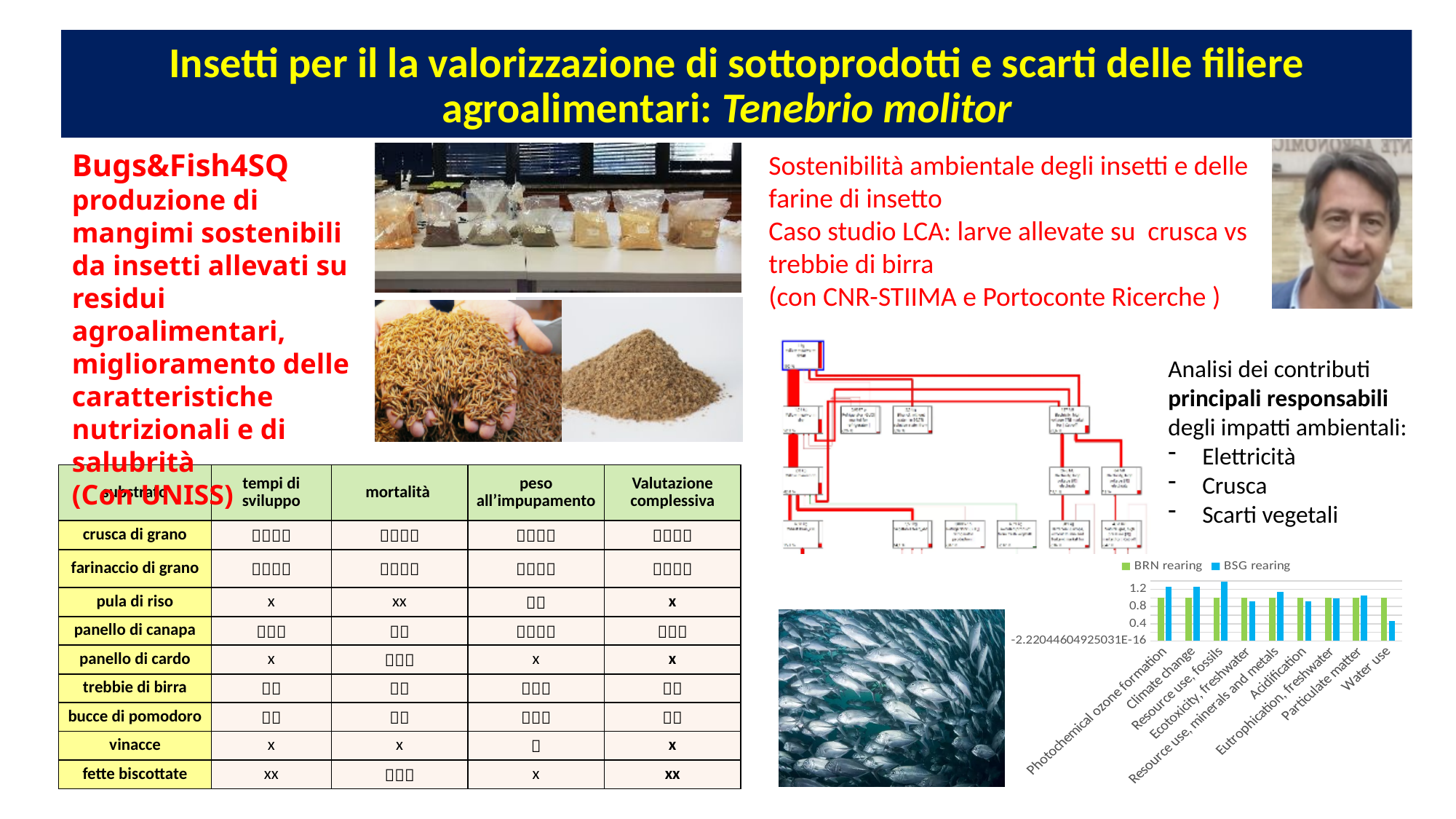
In the bar chart, is the BSG rearing value for Acidification greater or less than 0.4? greater In the bar chart, for Climate change, which series has the larger value: BRN rearing or BSG rearing? BSG rearing How many series does the legend of the bar chart list? 2 In the bar chart, for Water use, which series has the larger value: BRN rearing or BSG rearing? BRN rearing In the bar chart, is the BSG rearing value for Photochemical ozone formation greater or less than 0.8? greater What kind of chart is shown at the bottom right of the slide? bar chart In the bar chart, is the BSG rearing value for Water use greater or less than 0.8? less What are the two series named in the legend of the bar chart? BRN rearing and BSG rearing In the bar chart, which category has the lowest value for BSG rearing? Water use How many impact categories are shown on the x axis of the bar chart? 9 In the bar chart, which colour represents the BSG rearing series? blue